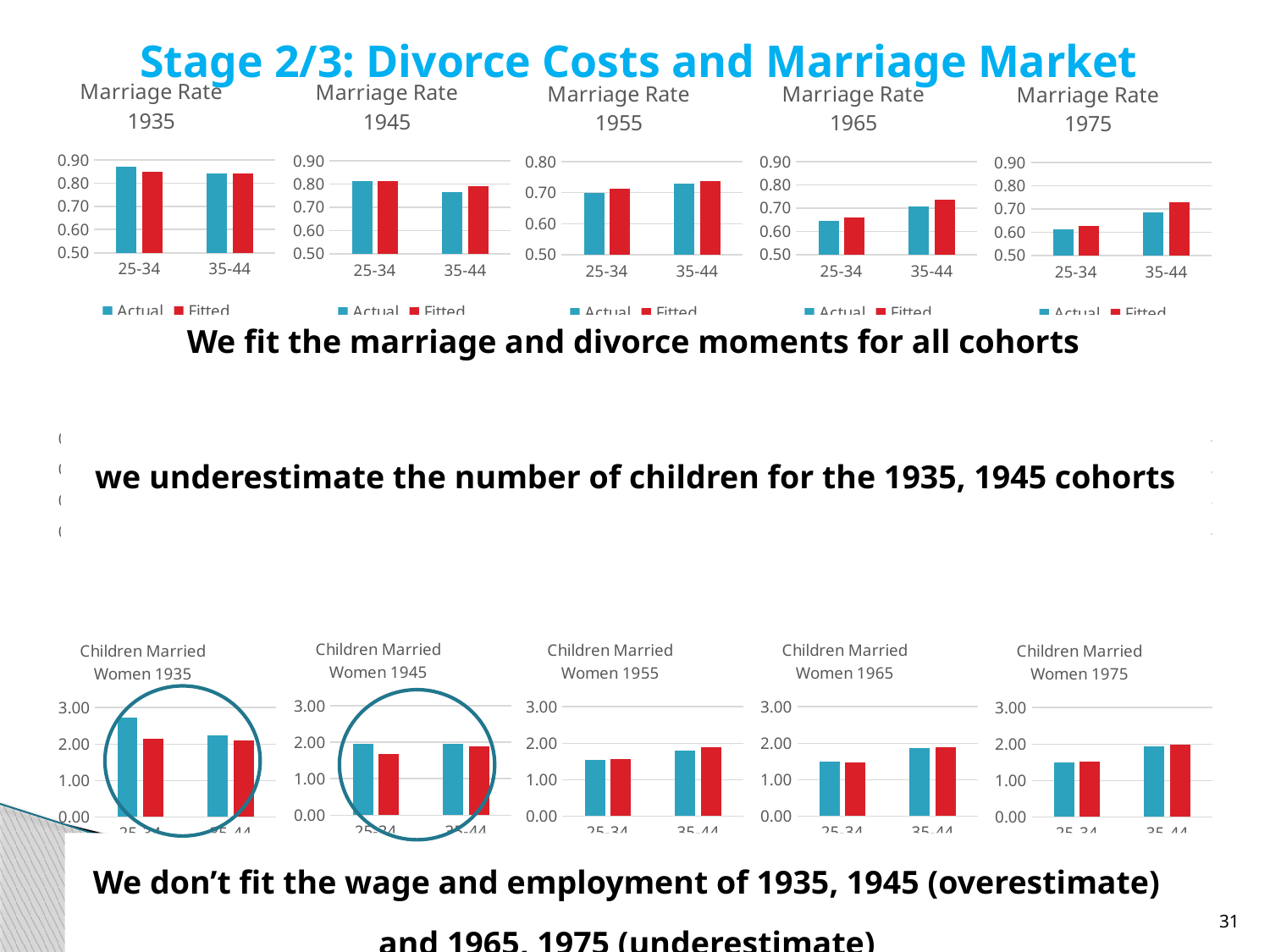
In the Children Married Women 1935 chart, is the Actual value for 25-34 greater or less than 2.00? greater In the Marriage Rate 1935 chart, do the Actual values rise or fall from 25-34 to 35-44? fall In the Children Married Women 1945 chart, is the Fitted value for 25-34 greater or less than 2.00? less In the Marriage Rate 1975 chart, is the Actual value for 25-34 greater or less than 0.70? less In the Marriage Rate 1965 chart, do the Actual values rise or fall from 25-34 to 35-44? rise In the Marriage Rate 1945 chart, which is larger for 35-44, the Actual or the Fitted value? Fitted In the Children Married Women 1935 chart, which is larger for 25-34, the Actual or the Fitted value? Actual What kind of chart is the Marriage Rate 1945 chart? bar chart How many series does the legend of the Marriage Rate 1955 chart list? 2